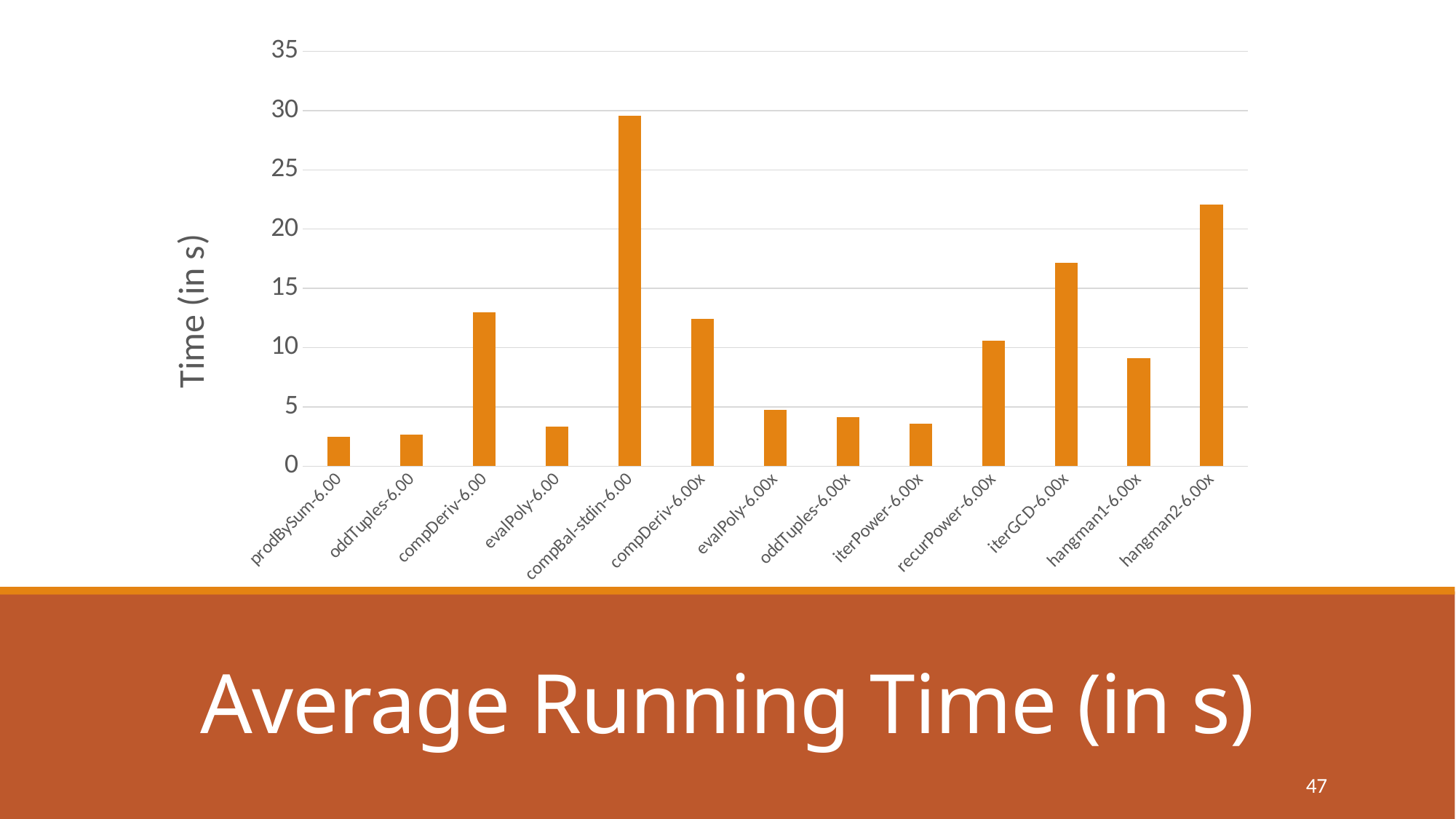
Is the value for hangman2-6.00x greater or less than 20? greater Which has a larger value, hangman2-6.00x or iterGCD-6.00x? hangman2-6.00x Which category has the highest average running time? compBal-stdin-6.00 Is the value for evalPoly-6.00 greater or less than 5? less Is the value for iterGCD-6.00x greater or less than 15? greater What kind of chart is shown on the slide? bar chart How many categories (bars) are plotted in the chart? 13 What is the label on the vertical axis of the chart? Time (in s) Which has a larger value, iterGCD-6.00x or recurPower-6.00x? iterGCD-6.00x